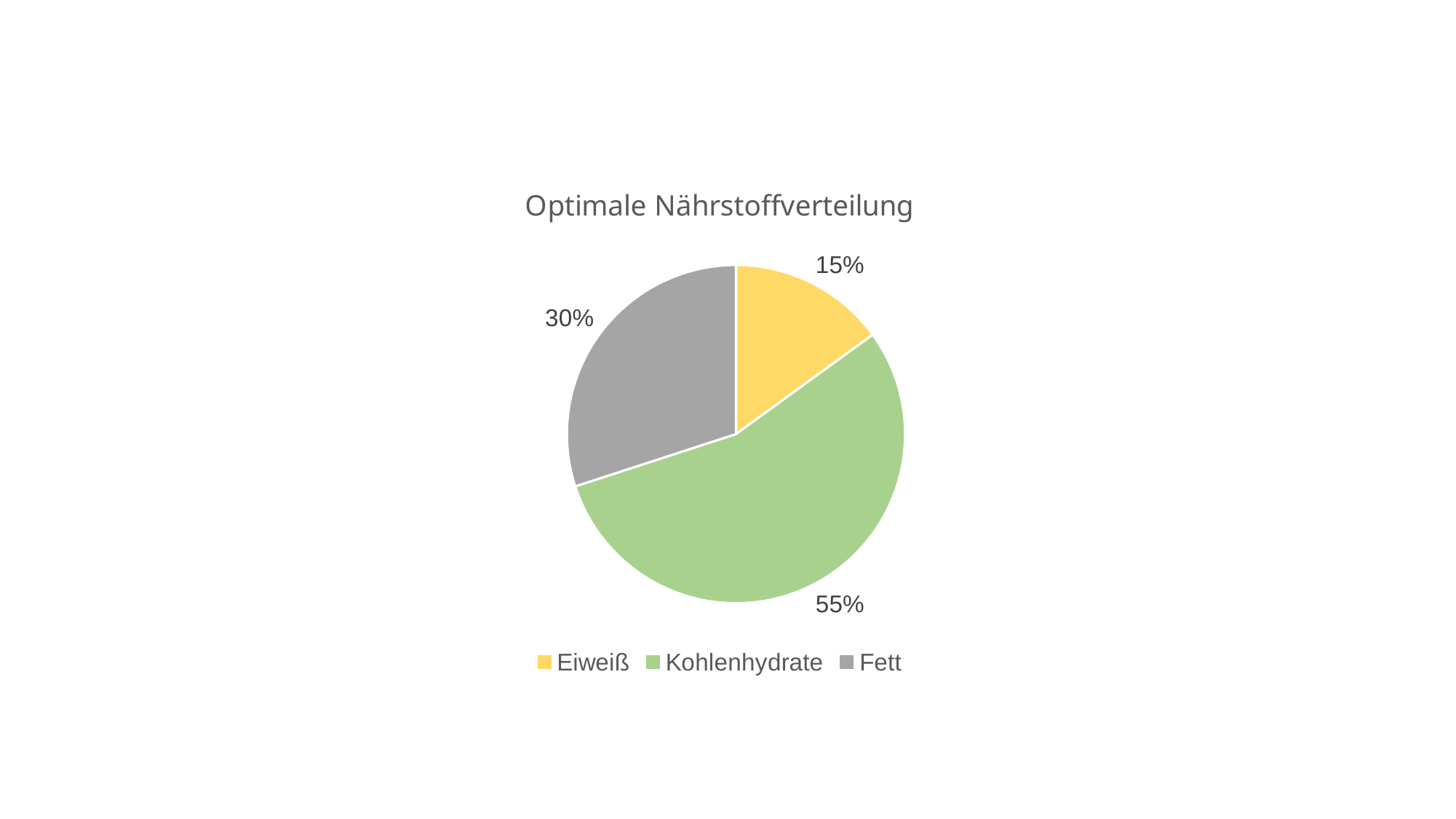
How many categories does the pie chart have? 3 What is the difference between the shares of Kohlenhydrate and Fett? 25% What is the title of the chart? Optimale Nährstoffverteilung What share of the pie does Kohlenhydrate have? 55% Which is larger, the share of Fett or the share of Eiweiß? Fett What is the difference between the shares of Fett and Eiweiß? 15% Which colour represents Fett in the legend? grey What share of the pie does Eiweiß have? 15% Which category has the smallest slice? Eiweiß What kind of chart is shown on the slide? pie chart What share of the pie does Fett have? 30% Which category has the largest slice? Kohlenhydrate